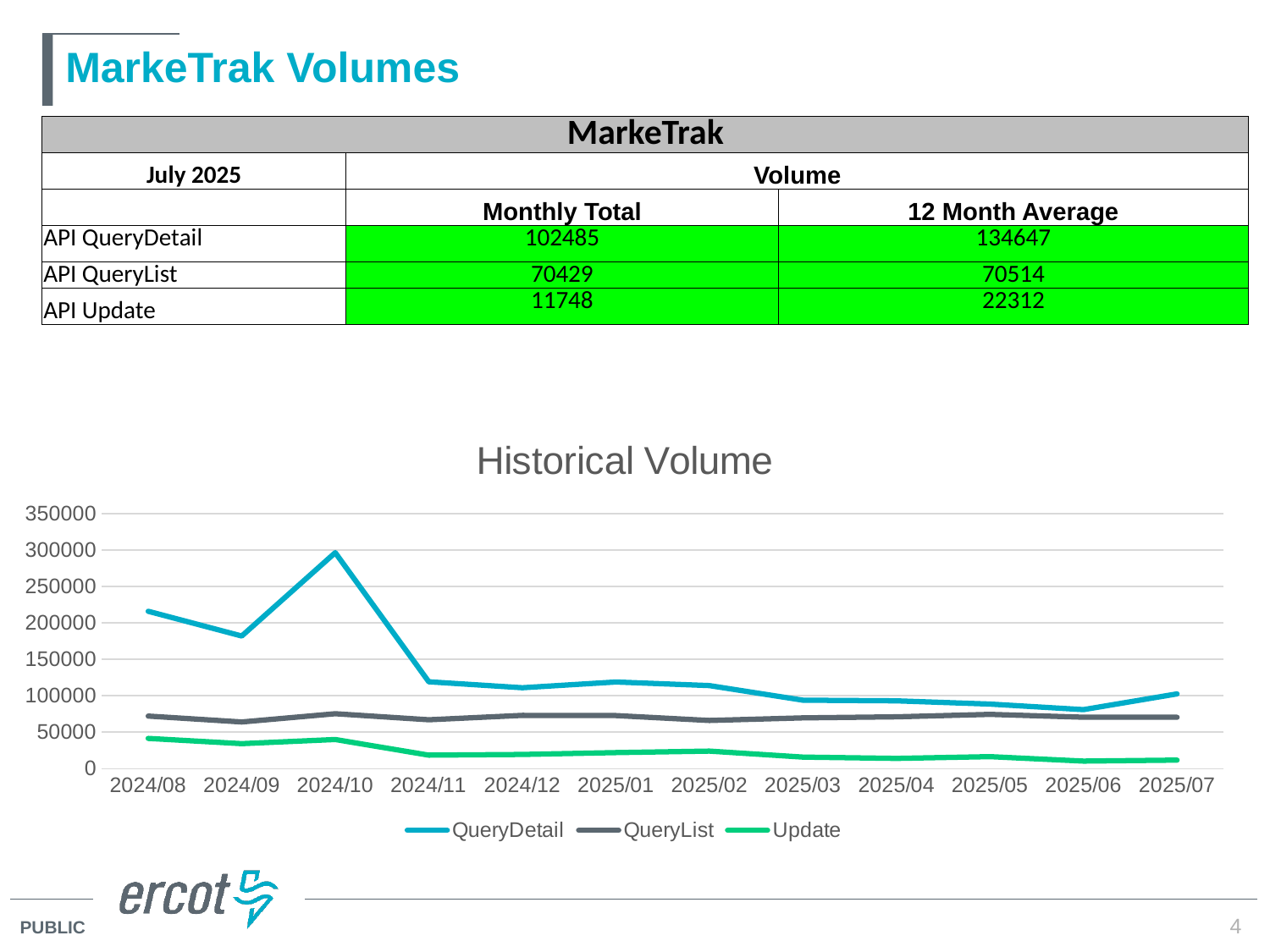
In the Historical Volume chart, is the Update value for 2024/08 greater or less than 50000? less What kind of chart is the Historical Volume chart? line chart What is the title of the line chart on the slide? Historical Volume How many months are shown on the x axis of the Historical Volume chart? 12 In the Historical Volume chart, is the QueryDetail value for 2024/10 greater or less than 250000? greater How many series does the legend of the Historical Volume chart list? 3 In the Historical Volume chart, is the QueryList value for 2024/10 greater or less than 100000? less In the Historical Volume chart, which month has the highest QueryDetail value? 2024/10 In the Historical Volume chart, does the QueryDetail line rise or fall from 2024/10 to 2024/11? fall In the Historical Volume chart, which series has the lowest values across all months? Update In the Historical Volume chart, which is larger at 2024/08: QueryDetail or QueryList? QueryDetail